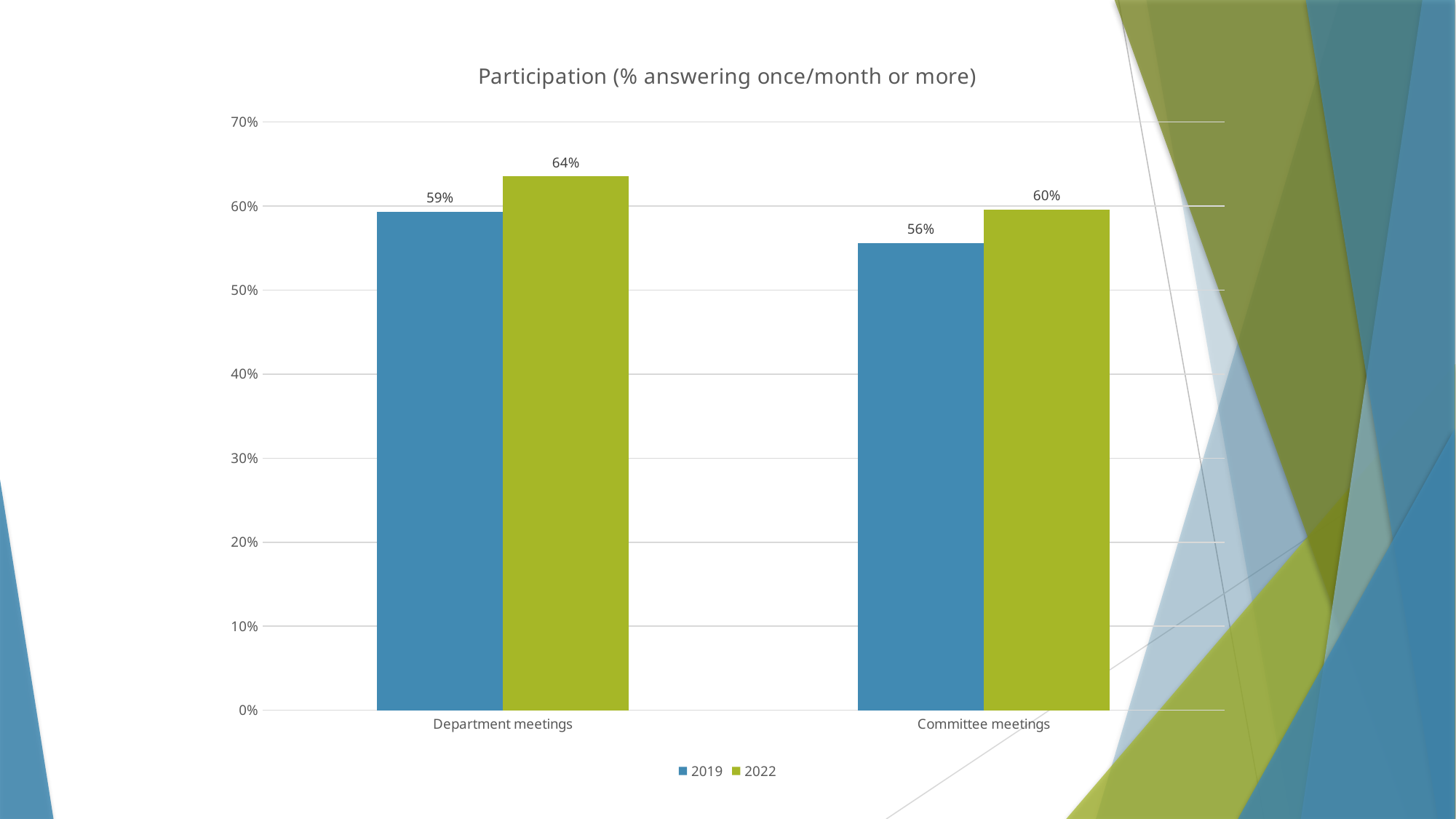
What kind of chart is shown on the slide? Bar chart What is the 2019 value for Department meetings? 59% What is the title of the chart? Participation (% answering once/month or more) What is the 2019 value for Committee meetings? 56% What is the difference between the 2022 and 2019 values for Department meetings? 5% What is the difference between the 2022 and 2019 values for Committee meetings? 4% How many categories are shown on the x axis? 2 What is the 2022 value for Committee meetings? 60% Which is larger: the 2019 value for Department meetings or the 2022 value for Committee meetings? 2022 value for Committee meetings Which category has the lowest 2019 value? Committee meetings How many series does the legend list? 2 Which category has the highest 2022 value? Department meetings